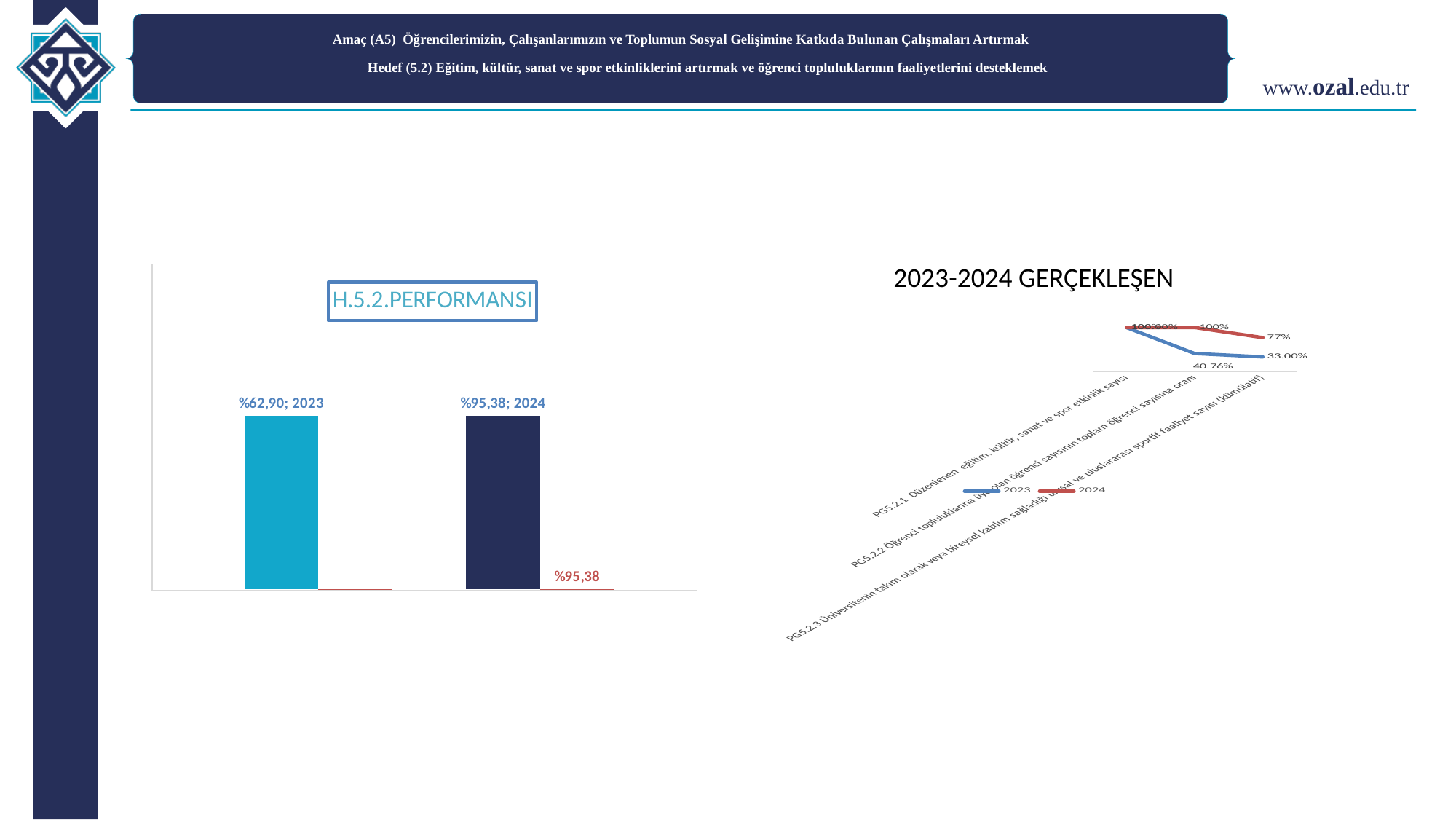
What kind of chart is the H.5.2.PERFORMANSI chart? bar chart In the 2023-2024 GERÇEKLEŞEN chart, what is the 2024 value for PG5.2.3? 77% How many bars are in the H.5.2.PERFORMANSI chart? 2 In the 2023-2024 GERÇEKLEŞEN chart, what is the 2023 value for PG5.2.3? 33.00% In the 2023-2024 GERÇEKLEŞEN chart, which series has the higher value for PG5.2.3, 2023 or 2024? 2024 How many series does the legend of the 2023-2024 GERÇEKLEŞEN chart list? 2 In the H.5.2.PERFORMANSI chart, what is the value for 2023? %62,90 In the H.5.2.PERFORMANSI chart, which year has the higher value? 2024 In the H.5.2.PERFORMANSI chart, what is the value for 2024? %95,38 What kind of chart is the 2023-2024 GERÇEKLEŞEN chart? line chart In the H.5.2.PERFORMANSI chart, what is the difference between the 2024 and 2023 values? %32,48 In the H.5.2.PERFORMANSI chart, does the value rise or fall from 2023 to 2024? rise